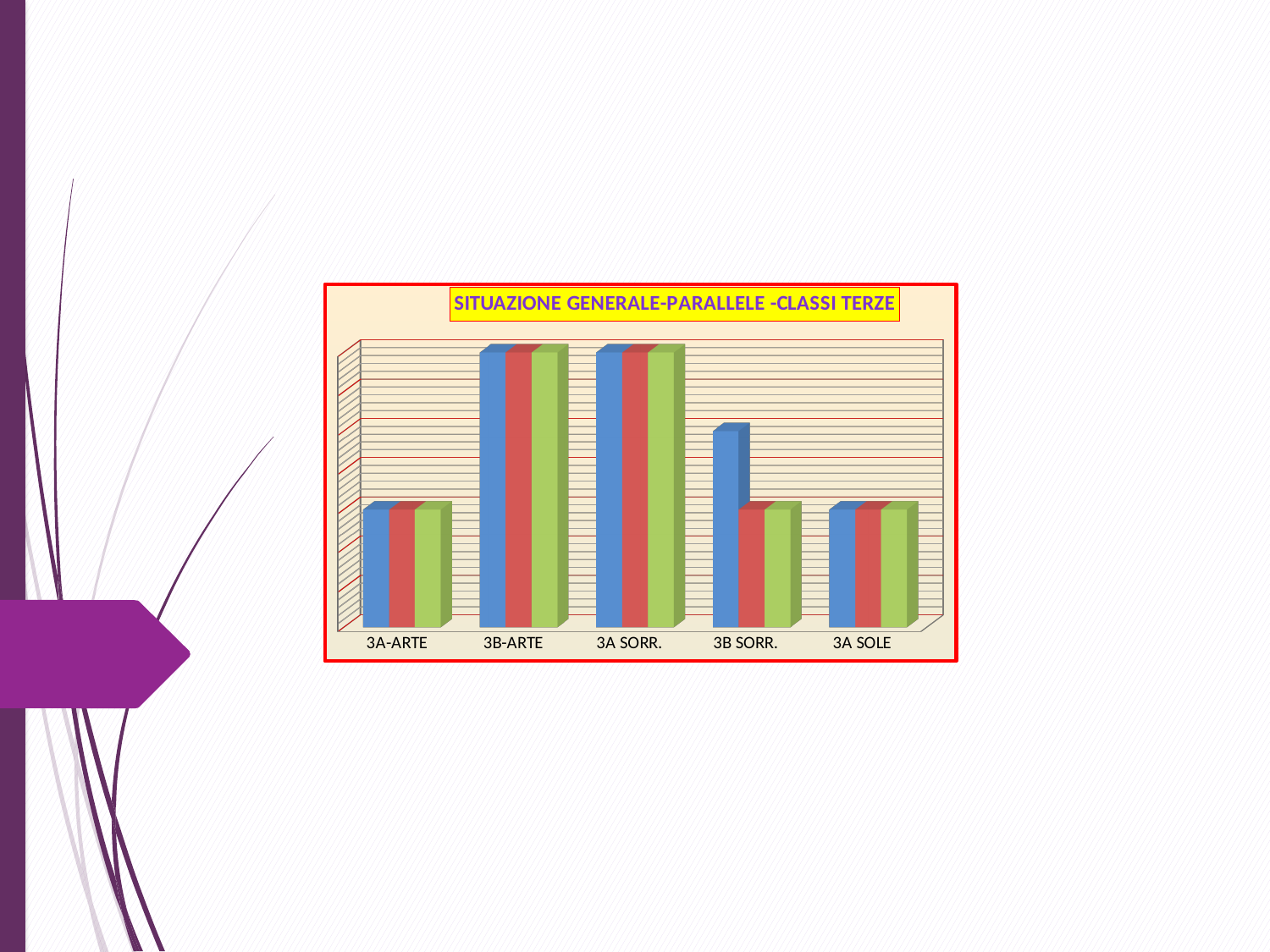
What kind of chart is shown on the slide? Bar chart Which is larger, the blue bar for 3B-ARTE or the blue bar for 3A-ARTE? 3B-ARTE Which is larger, the green bar for 3A SORR. or the green bar for 3A SOLE? 3A SORR. What is the title of the chart? SITUAZIONE GENERALE-PARALLELE -CLASSI TERZE Do the values rise steadily from left to right across the categories in the chart? No How many categories are shown on the x axis of the chart? 5 Which is larger, the red bar for 3B-ARTE or the red bar for 3B SORR.? 3B-ARTE How many bars are plotted for each category in the chart? 3